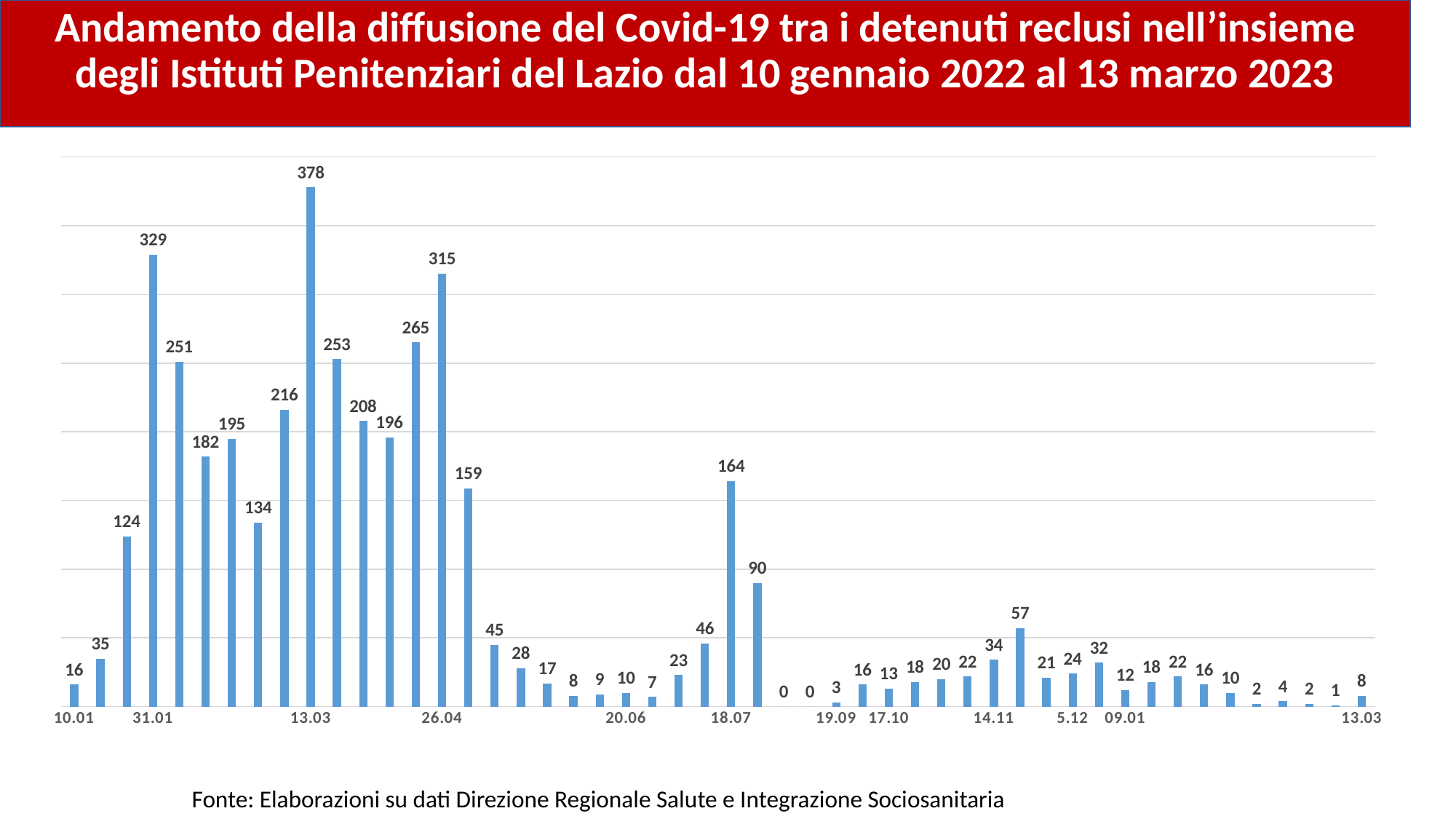
Which date has the highest value in the chart? 13.03 (2022), with 378 Which is larger, the value for 31.01 or the value for 26.04? 31.01 What is the value for 10.01? 16 What kind of chart is shown on the slide? bar chart What is the value for 31.01? 329 What is the value for 18.07? 164 What source is cited below the chart? Elaborazioni su dati Direzione Regionale Salute e Integrazione Sociosanitaria Do the values rise or fall between 19.09 and 14.11? rise What is the value for 14.11? 34 What is the difference between the value for 13.03 (2022) and the value for 31.01? 49 What is the value for 26.04? 315 What is the value for the last date, 13.03 (2023)? 8